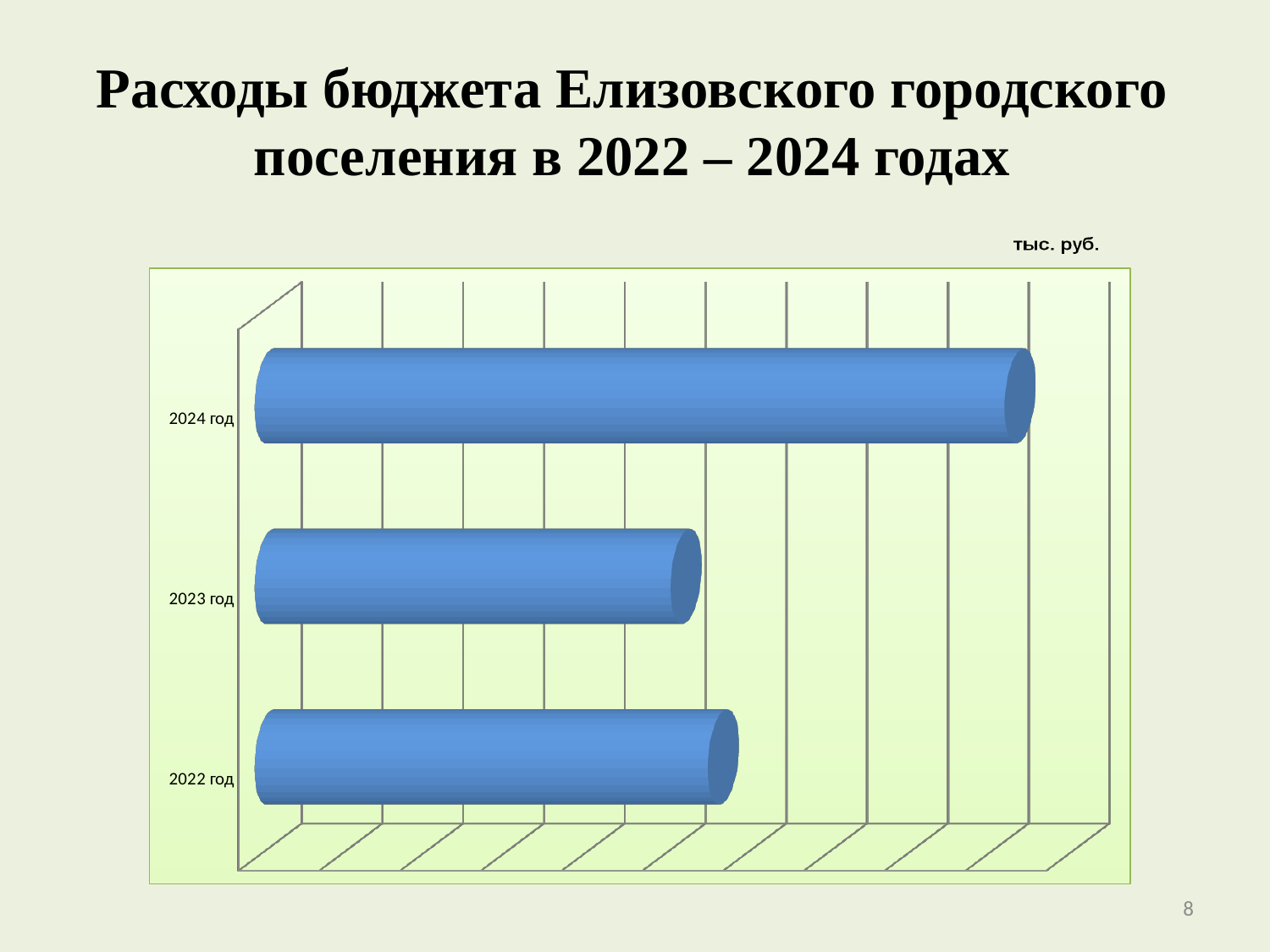
What kind of chart is shown on the slide? bar chart How many categories (years) are plotted in the chart? 3 What unit of measurement is indicated above the chart? тыс. руб. Which year has the lowest budget expenditure in the chart? 2023 год Which is larger in the chart: the value for 2022 год or the value for 2023 год? 2022 год What is the title of the slide containing the chart? Расходы бюджета Елизовского городского поселения в 2022 – 2024 годах Which is larger in the chart: the value for 2024 год or the value for 2022 год? 2024 год Which year has the highest budget expenditure in the chart? 2024 год Do the values rise or fall from 2022 год to 2023 год? fall Which is larger in the chart: the value for 2024 год or the value for 2023 год? 2024 год Do the values rise or fall from 2023 год to 2024 год? rise